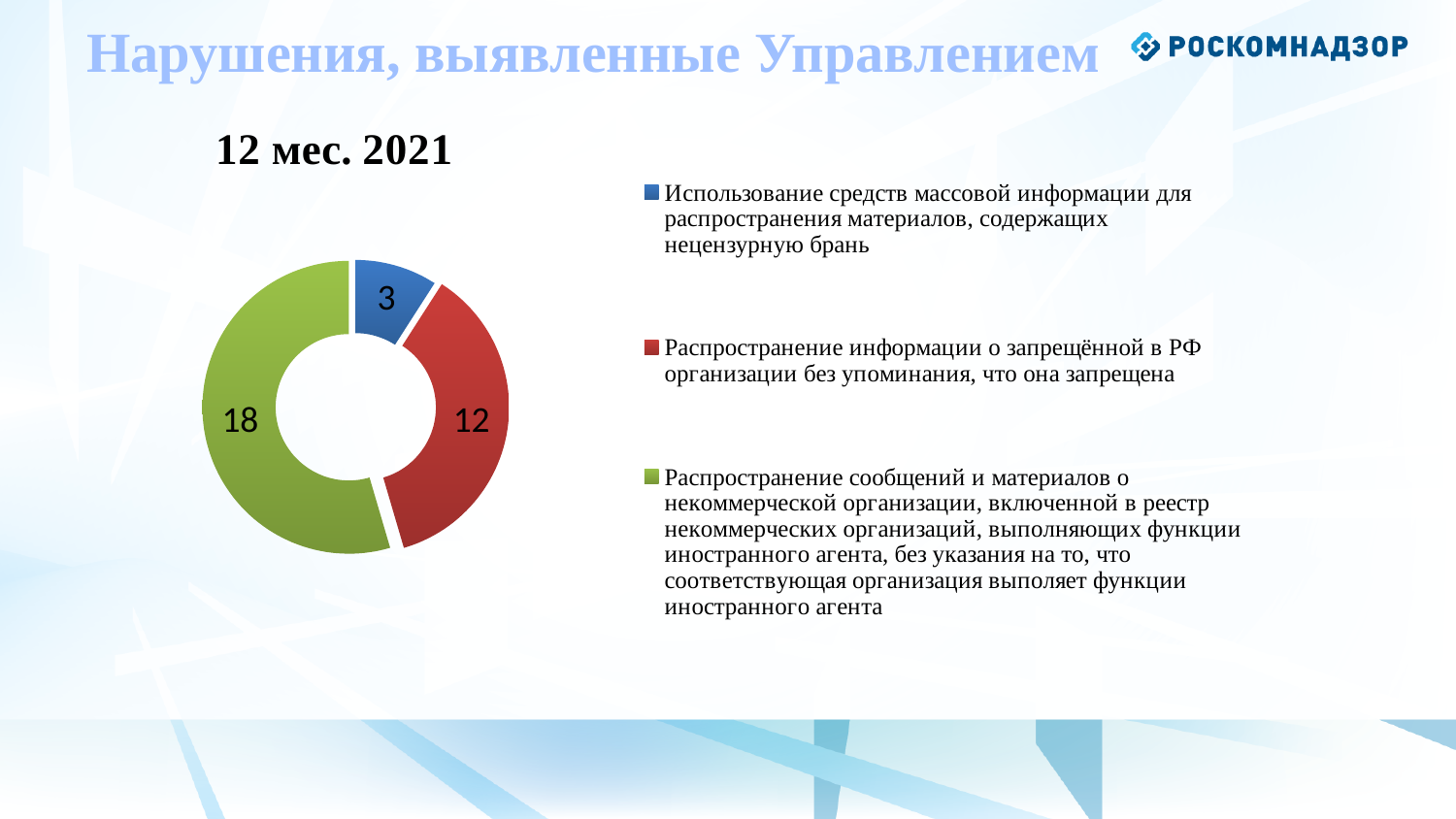
What is the total of all slices in the chart? 33 What is the value for the slice 'Распространение информации о запрещённой в РФ организации без упоминания, что она запрещена'? 12 How many slices does the chart have? 3 What kind of chart is shown on the slide? Doughnut (pie) chart Which category has the lowest value in the chart? Использование средств массовой информации для распространения материалов, содержащих нецензурную брань What is the difference between the largest slice (18) and the smallest slice (3)? 15 Which is larger: the value for the red slice or the value for the green slice? The green slice (18) What period is shown in the chart's title? 12 мес. 2021 What is the difference between the red slice (12) and the blue slice (3)? 9 What is the value for the green slice about messages and materials on a non-commercial organization performing the functions of a foreign agent? 18 What is the value for the slice 'Использование средств массовой информации для распространения материалов, содержащих нецензурную брань'? 3